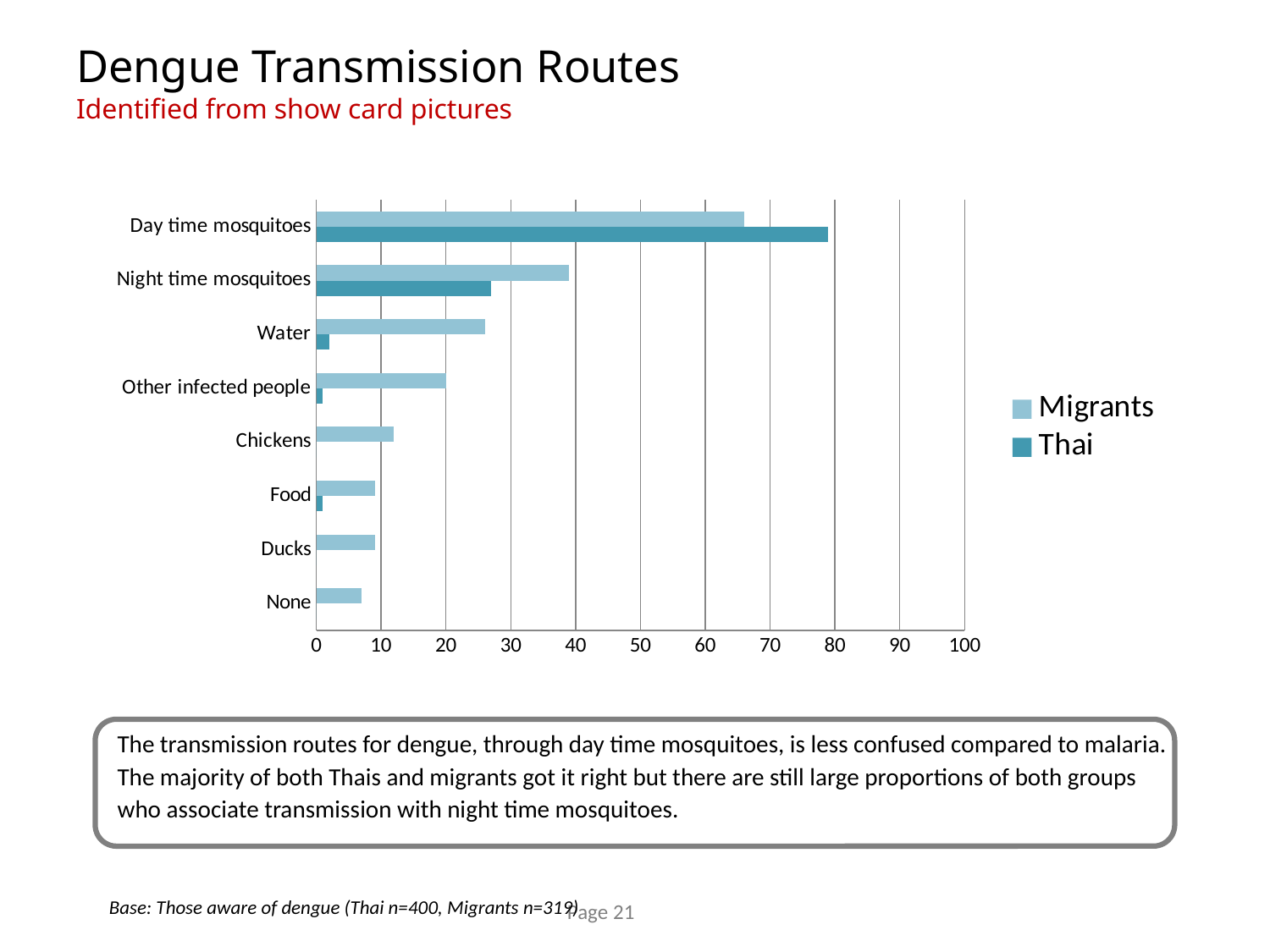
Is the Thai value for Water greater or less than 10? less For Night time mosquitoes, which series has the larger value, Migrants or Thai? Migrants How many categories are plotted on the chart? 8 Which category has the highest value for Thai? Day time mosquitoes How many series does the legend list? 2 What kind of chart is shown on the slide? bar chart Is the Migrants value for Day time mosquitoes greater or less than 60? greater Which category has the highest value for Migrants? Day time mosquitoes What are the two entries listed in the chart legend? Migrants and Thai Is the Thai value for Day time mosquitoes greater or less than 70? greater For Day time mosquitoes, which series has the larger value, Migrants or Thai? Thai